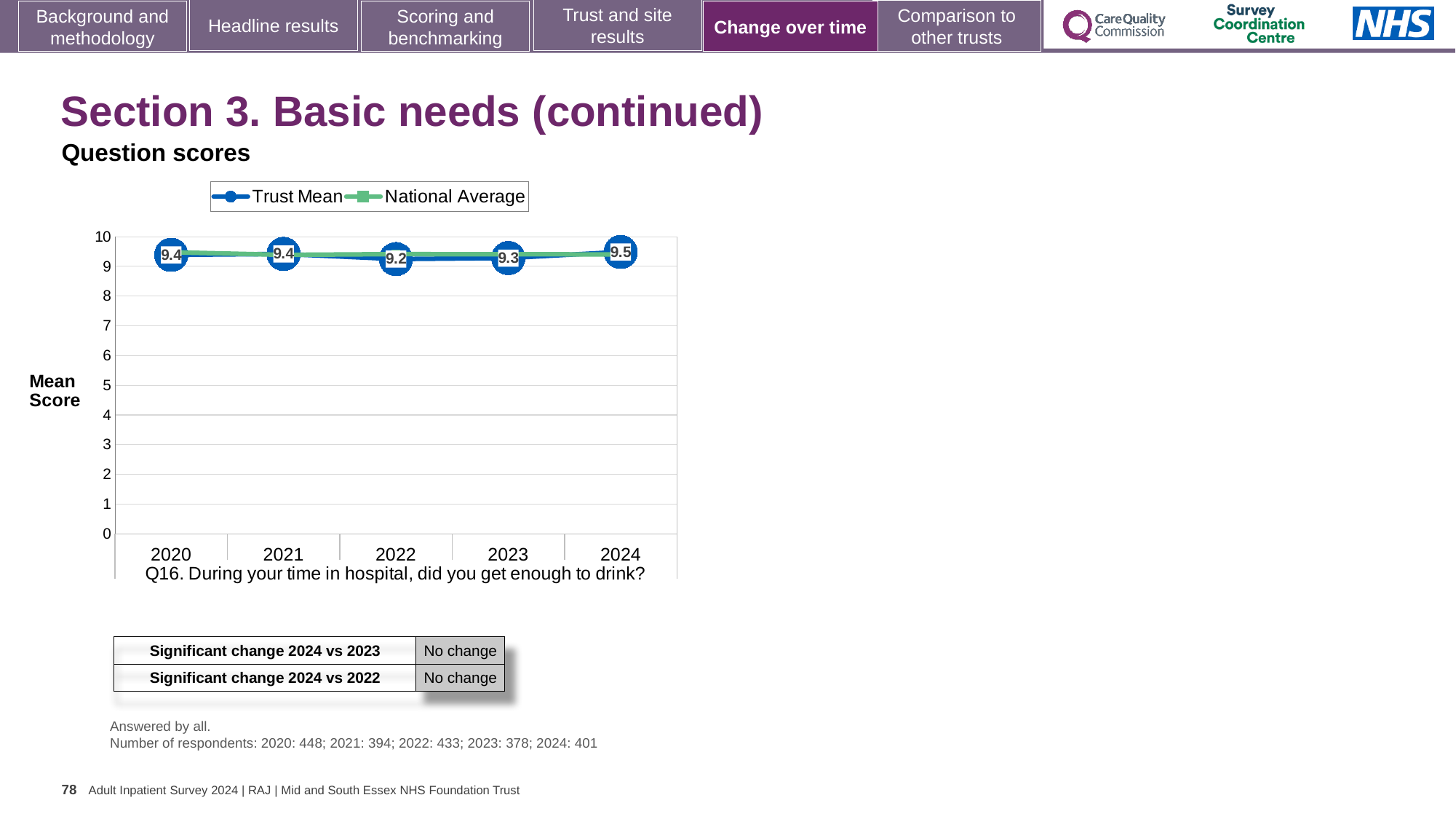
Is the National Average value for 2024 greater or less than 8? greater What kind of chart is shown on the slide? Line chart Which year has the larger Trust Mean score, 2023 or 2024? 2024 What is the difference between the Trust Mean score in 2024 and in 2022? 0.3 What is the Trust Mean score for 2024? 9.5 In which year is the Trust Mean score highest? 2024 In which year is the Trust Mean score lowest? 2022 What is the Trust Mean score for 2022? 9.2 How many years are plotted on the x axis? 5 How many series does the legend list? 2 Which survey question does the chart show scores for? Q16. During your time in hospital, did you get enough to drink? What is the Trust Mean score for 2020? 9.4